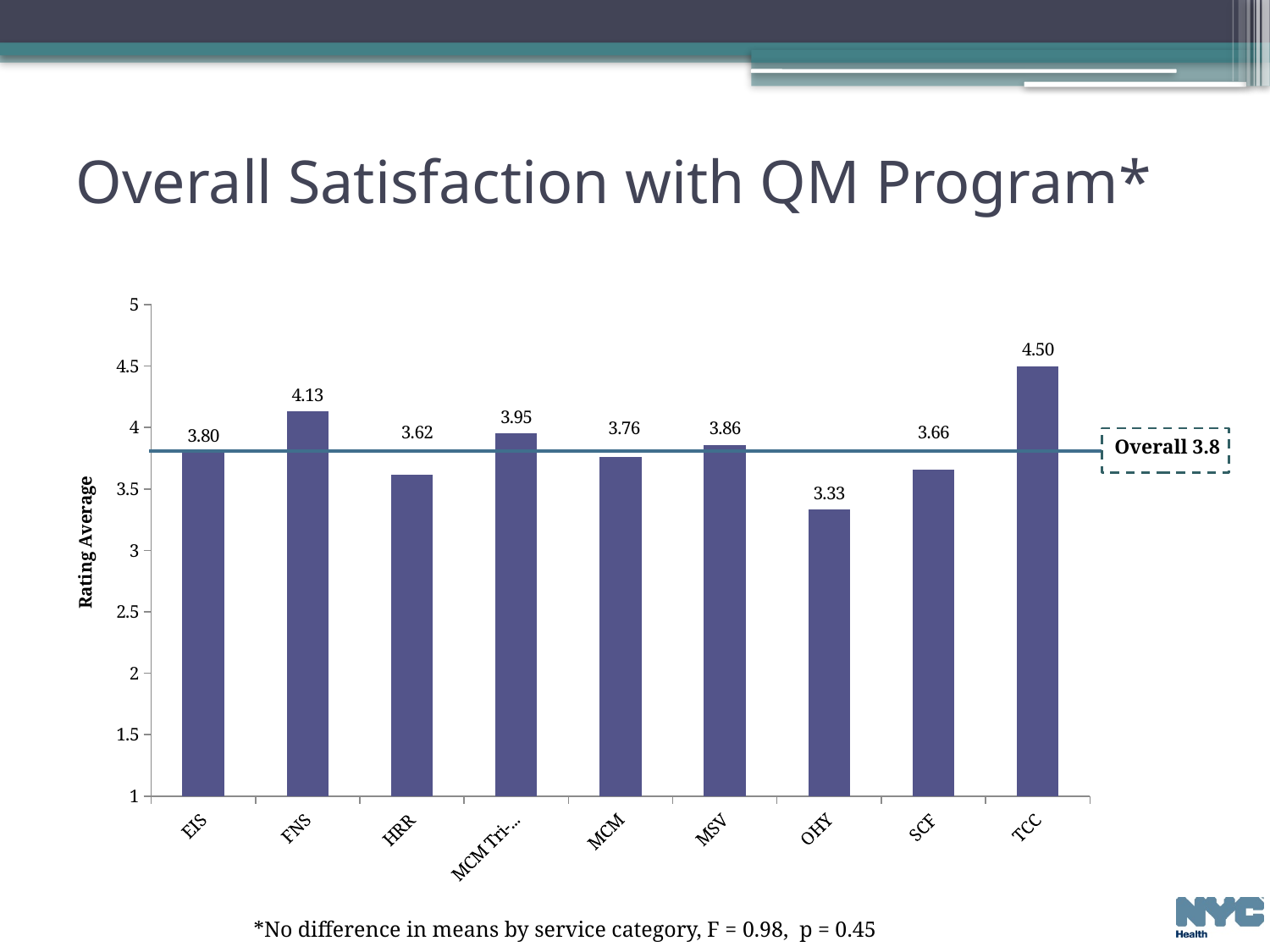
Which service category has the lowest rating average? OHY How many service categories are shown on the x axis? 9 Which service category has the highest rating average? TCC Which has a higher rating average, FNS or HRR? FNS What is the rating average for TCC? 4.50 Is the value for MSV greater or less than 3.5? greater What is the difference between the rating averages for TCC and OHY? 1.17 What is the rating average for OHY? 3.33 What overall value is marked by the horizontal line across the chart? 3.8 What is the rating average for FNS? 4.13 What is the rating average for SCF? 3.66 What kind of chart is shown on the slide? Bar chart